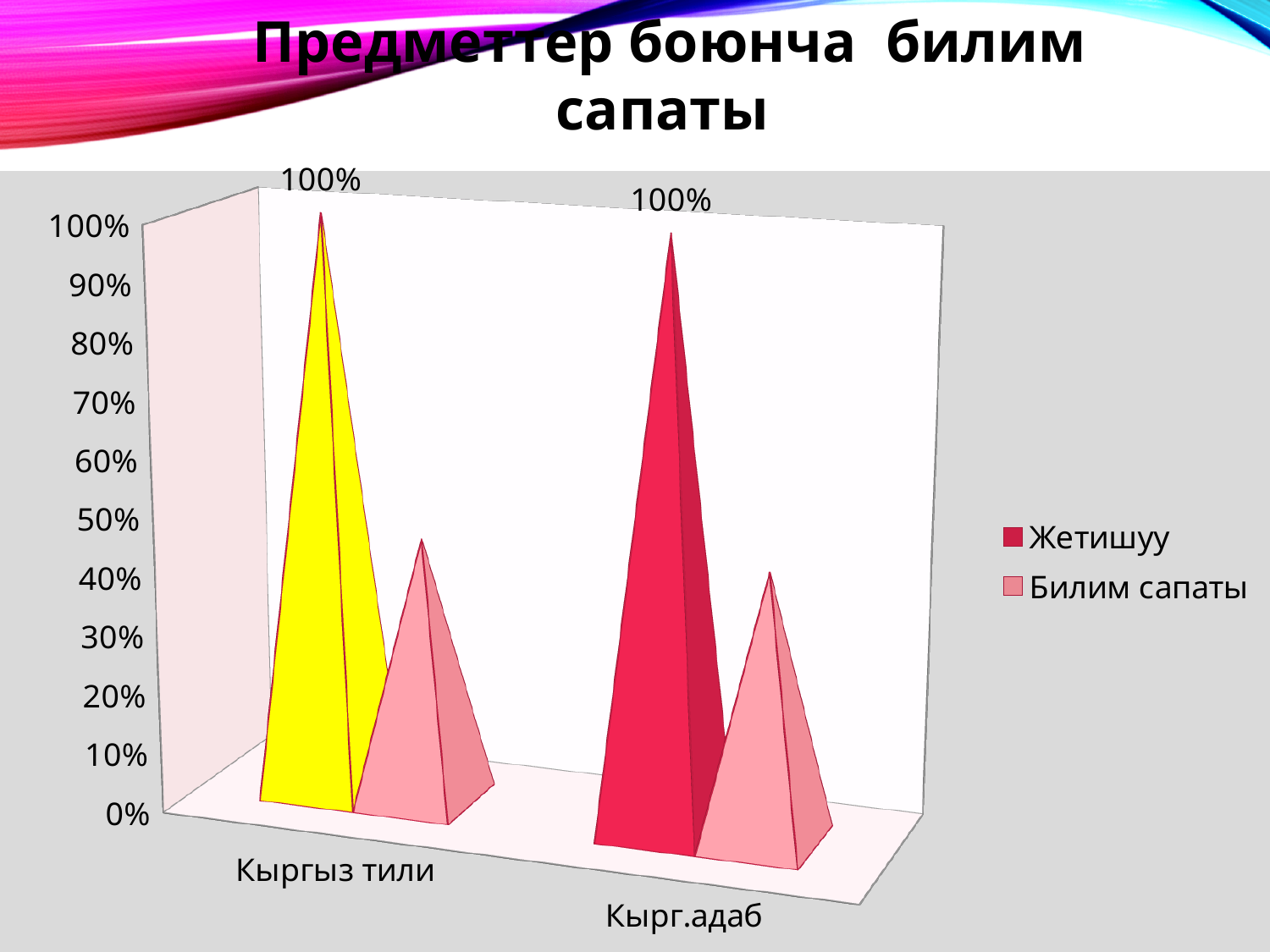
Which series has the higher value for Кыргыз тили, Жетишуу or Билим сапаты? Жетишуу How many categories are shown on the x axis? 2 Is the value of Билим сапаты for Кыргыз тили greater or less than 60%? less What are the two series names listed in the legend? Жетишуу and Билим сапаты What is the title of the chart on the slide? Предметтер боюнча билим сапаты What is the value of Жетишуу for Кыргыз тили? 100% What kind of chart is shown on the slide? bar chart Is the value of Билим сапаты for Кырг.адаб greater or less than 20%? greater Is the value of Билим сапаты for Кырг.адаб greater or less than 60%? less What is the value of Жетишуу for Кырг.адаб? 100% Which series has the higher value for Кырг.адаб, Жетишуу or Билим сапаты? Жетишуу How many series does the legend list? 2